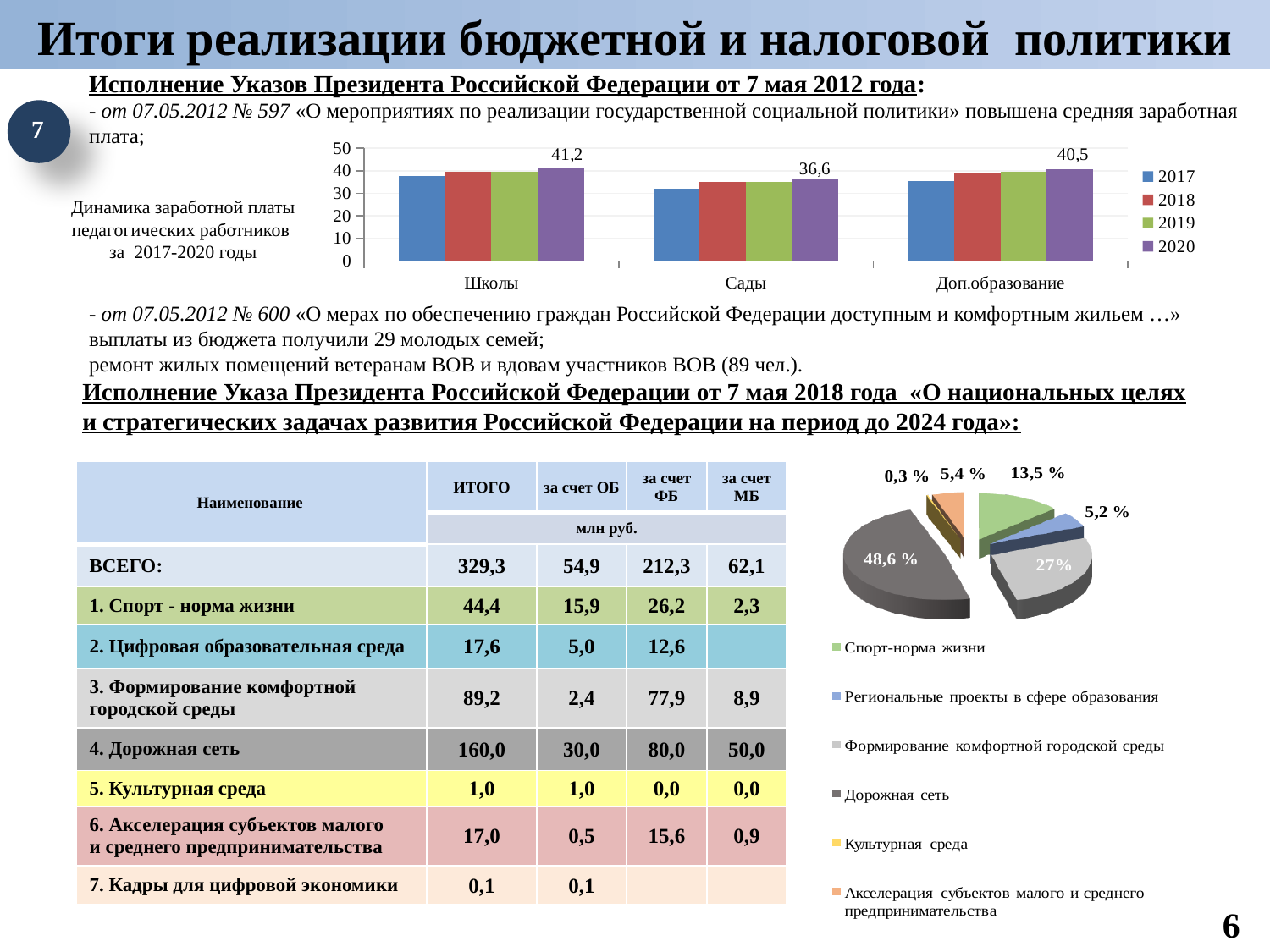
In the bar chart 'Динамика заработной платы педагогических работников за 2017-2020 годы', which category has the highest 2020 value? Школы In the pie chart at the bottom right of the slide, how many entries does the legend list? 6 In the pie chart at the bottom right of the slide, what share does Спорт-норма жизни have? 13,5 % What kind of chart is the chart at the top of the slide showing teachers' salaries for 2017-2020? bar chart In the bar chart 'Динамика заработной платы педагогических работников за 2017-2020 годы', what is the value for Доп.образование in 2020? 40,5 In the bar chart 'Динамика заработной платы педагогических работников за 2017-2020 годы', how many series does the legend list? 4 In the bar chart 'Динамика заработной платы педагогических работников за 2017-2020 годы', how many categories are shown on the x axis? 3 In the bar chart 'Динамика заработной платы педагогических работников за 2017-2020 годы', what is the value for Школы in 2020? 41,2 In the bar chart 'Динамика заработной платы педагогических работников за 2017-2020 годы', what is the difference between the 2020 values for Школы and Сады? 4,6 In the pie chart at the bottom right of the slide, which legend entry has the largest share? Дорожная сеть In the bar chart 'Динамика заработной платы педагогических работников за 2017-2020 годы', what is the value for Сады in 2020? 36,6 In the bar chart 'Динамика заработной платы педагогических работников за 2017-2020 годы', is the 2017 value for Сады greater or less than 40? less